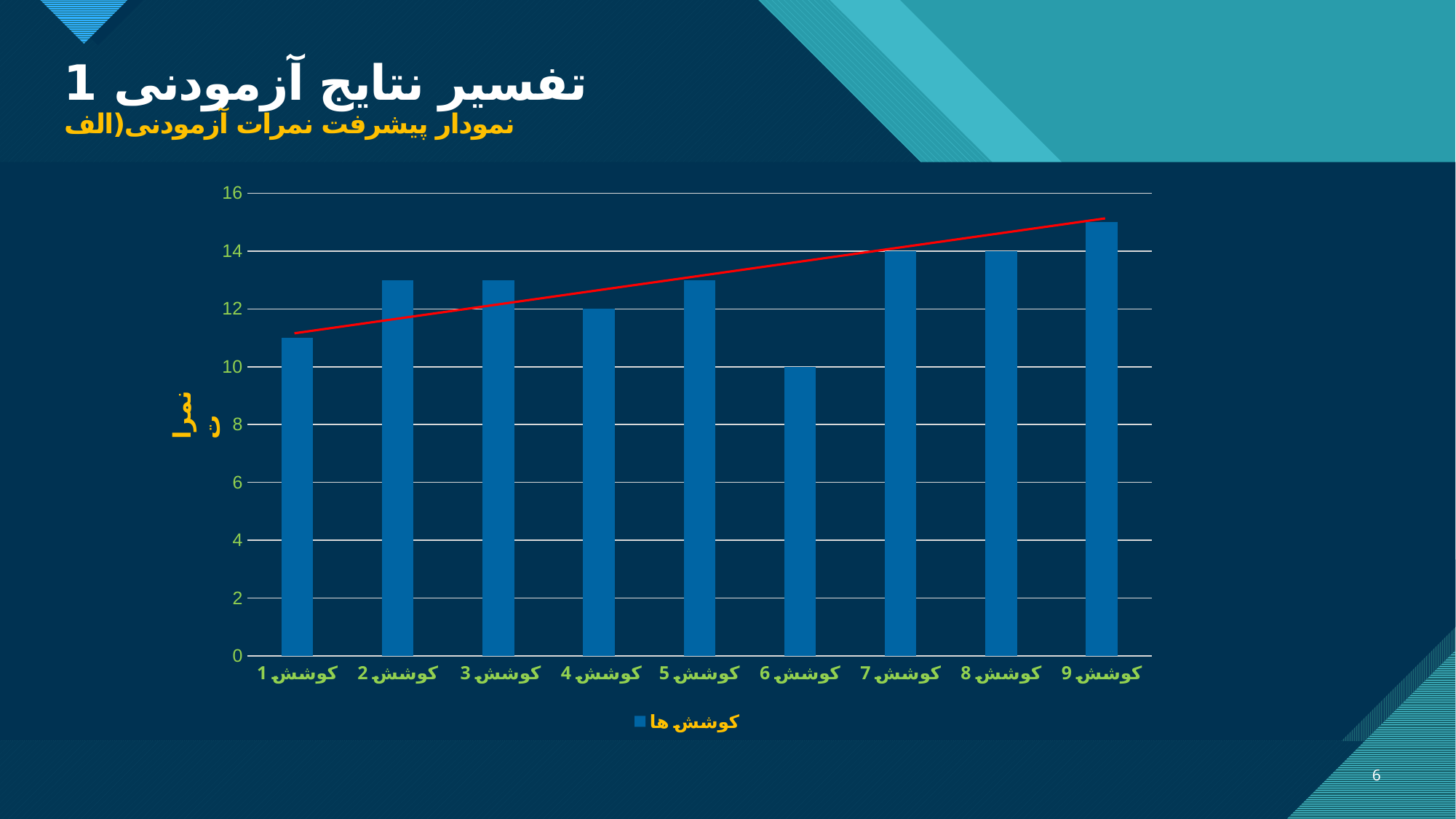
How many categories (کوشش) are plotted on the x axis? 9 Which category has the lowest bar? کوشش 6 How many series does the legend list? 1 What kind of chart is shown on the slide? bar chart What is the value for کوشش 6? 10 What is the value for کوشش 4? 12 Which category has the highest bar? کوشش 9 What is the difference between the values for کوشش 7 and کوشش 6? 4 What is the legend entry shown below the chart? کوشش ها Is the value for کوشش 9 greater or less than 14? greater What is the value for کوشش 7? 14 Which is larger, the value for کوشش 9 or the value for کوشش 6? کوشش 9